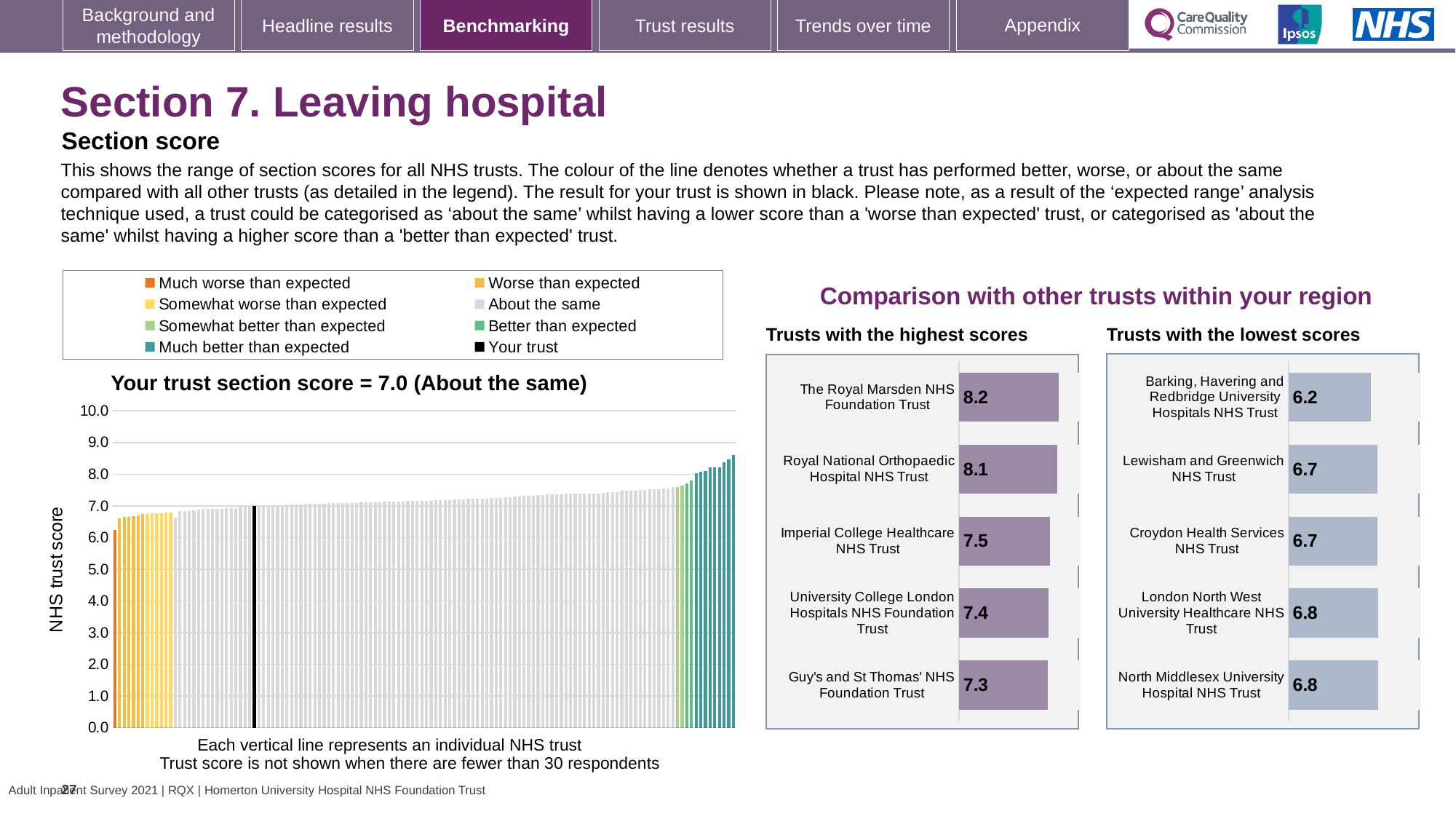
In the 'Trusts with the lowest scores' chart, what is the difference between the scores of North Middlesex University Hospital NHS Trust and Barking, Havering and Redbridge University Hospitals NHS Trust? 0.6 In the main section score chart on the left, what is the section score for your trust? 7.0 In the 'Trusts with the highest scores' chart, which has the larger score: Royal National Orthopaedic Hospital NHS Trust or Imperial College Healthcare NHS Trust? Royal National Orthopaedic Hospital NHS Trust In the 'Trusts with the highest scores' chart, what is the difference between the scores of The Royal Marsden NHS Foundation Trust and Guy's and St Thomas' NHS Foundation Trust? 0.9 In the 'Trusts with the highest scores' chart, what is the score for The Royal Marsden NHS Foundation Trust? 8.2 In the 'Trusts with the highest scores' chart, which trust has the highest score? The Royal Marsden NHS Foundation Trust In the 'Trusts with the lowest scores' chart, what is the score for Barking, Havering and Redbridge University Hospitals NHS Trust? 6.2 In the 'Trusts with the highest scores' chart, what is the score for Guy's and St Thomas' NHS Foundation Trust? 7.3 How many trusts are shown in the 'Trusts with the lowest scores' chart? 5 How many entries does the legend of the main section score chart on the left list? 8 In the main section score chart on the left, do the trust scores rise or fall from left to right along the x axis? rise In the 'Trusts with the lowest scores' chart, which trust has the lowest score? Barking, Havering and Redbridge University Hospitals NHS Trust